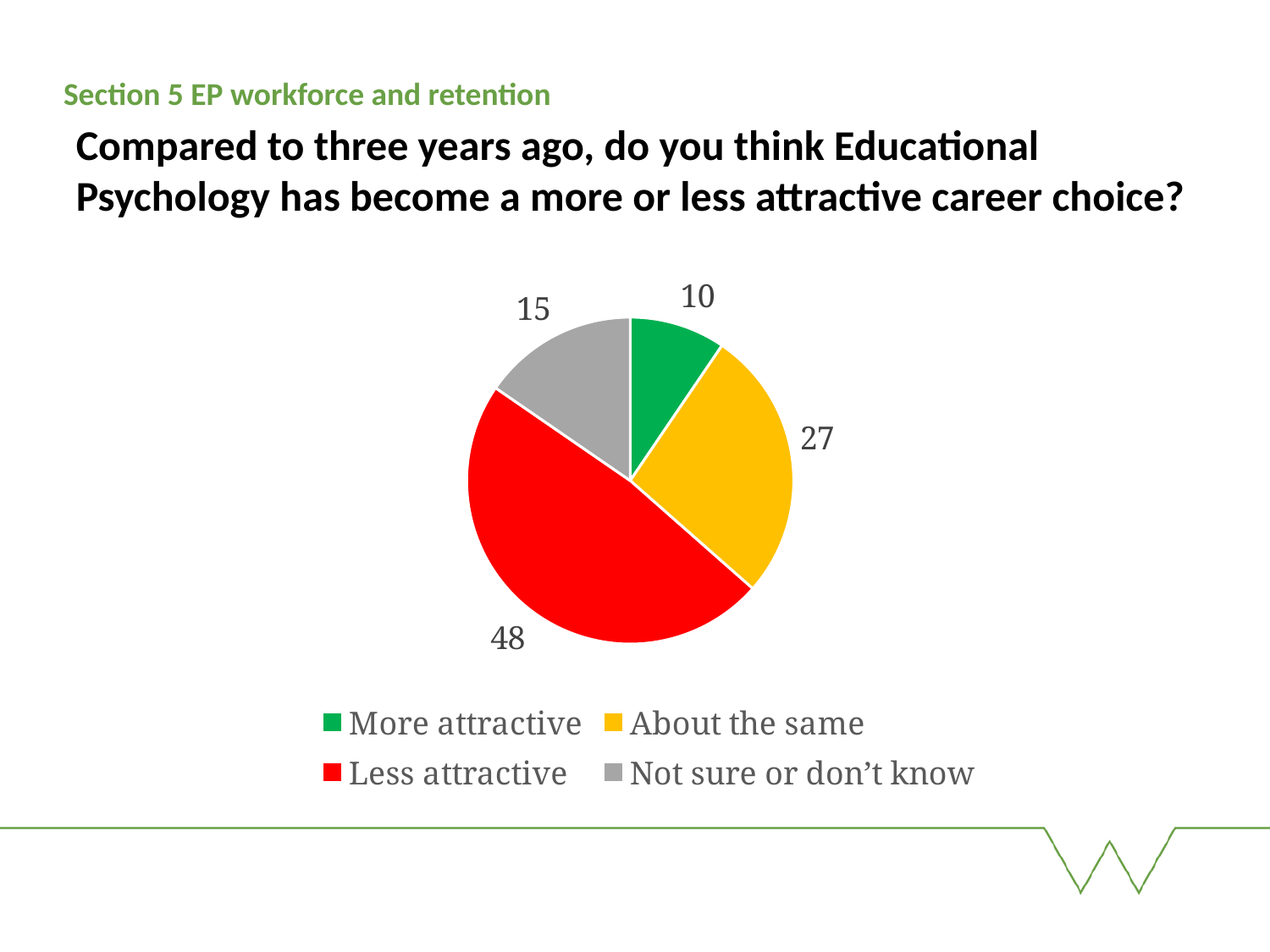
What colour is the Less attractive slice? Red What is the difference between the values for Less attractive and About the same? 21 What value is shown for the More attractive slice? 10 How many categories does the pie chart show? 4 What value is shown for the Less attractive slice? 48 What share of the pie does the Less attractive slice represent? 48% What kind of chart is shown on the slide? Pie chart Which category has the smallest slice of the pie? More attractive What value is shown for the About the same slice? 27 What value is shown for the Not sure or don't know slice? 15 Which is larger, the value for Not sure or don't know or the value for More attractive? Not sure or don't know Which category has the largest slice of the pie? Less attractive